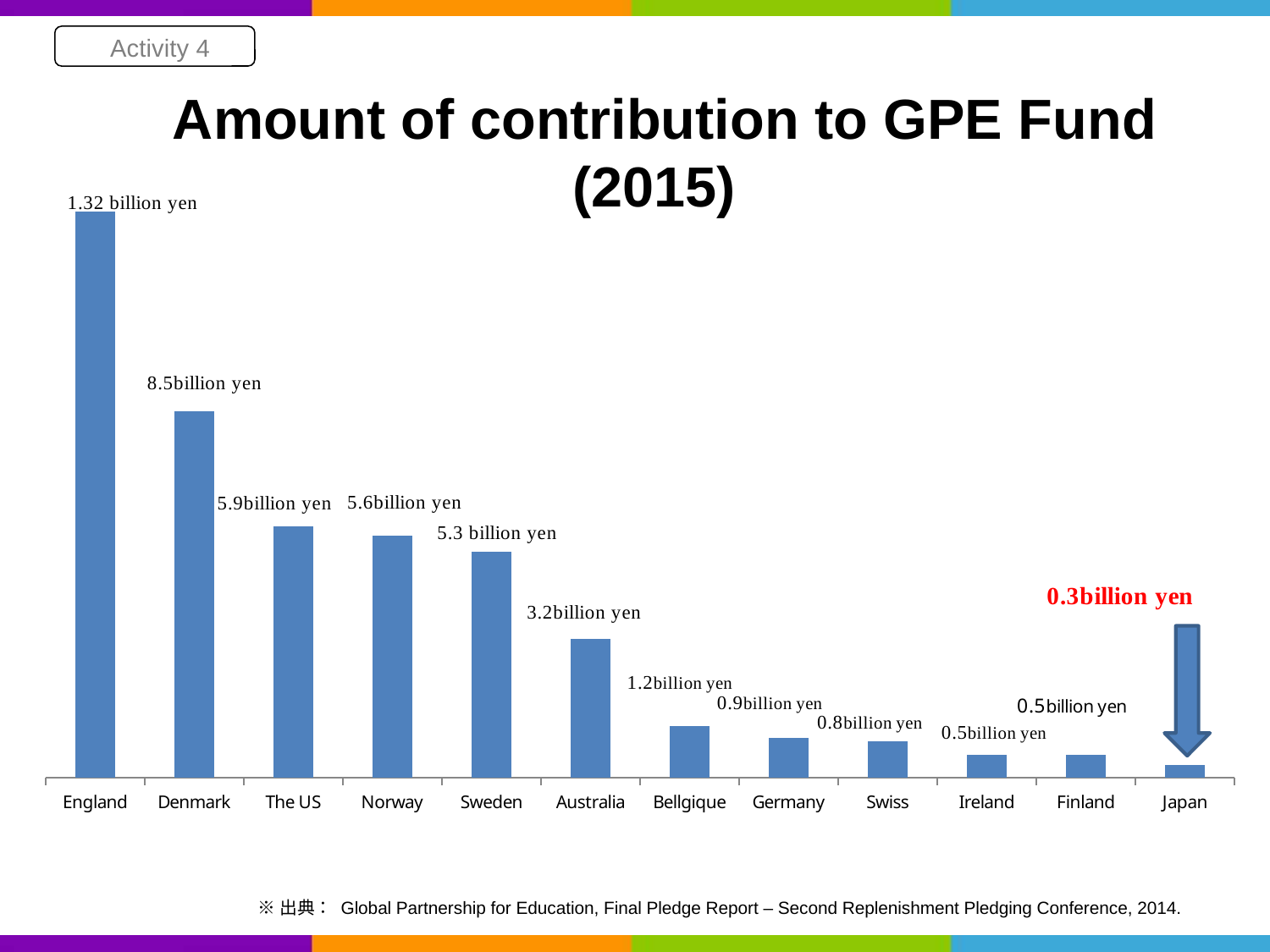
Which contributed more to the GPE Fund, Germany or Bellgique? Bellgique Which country has the highest contribution to the GPE Fund in the chart? England What is the contribution amount shown for Australia? 3.2billion yen Which country has the lowest contribution to the GPE Fund in the chart? Japan What is the contribution amount shown for Denmark? 8.5billion yen Do the contribution values rise or fall from left to right across the chart? Fall What type of chart is used on this slide? Bar chart What is the difference between the contributions of Sweden and Australia? 2.1 billion yen What is the contribution amount shown for Norway? 5.6billion yen How many countries are shown in the chart? 12 What is the contribution amount shown for Japan? 0.3billion yen What is the difference between the contributions of Denmark and The US? 2.6 billion yen